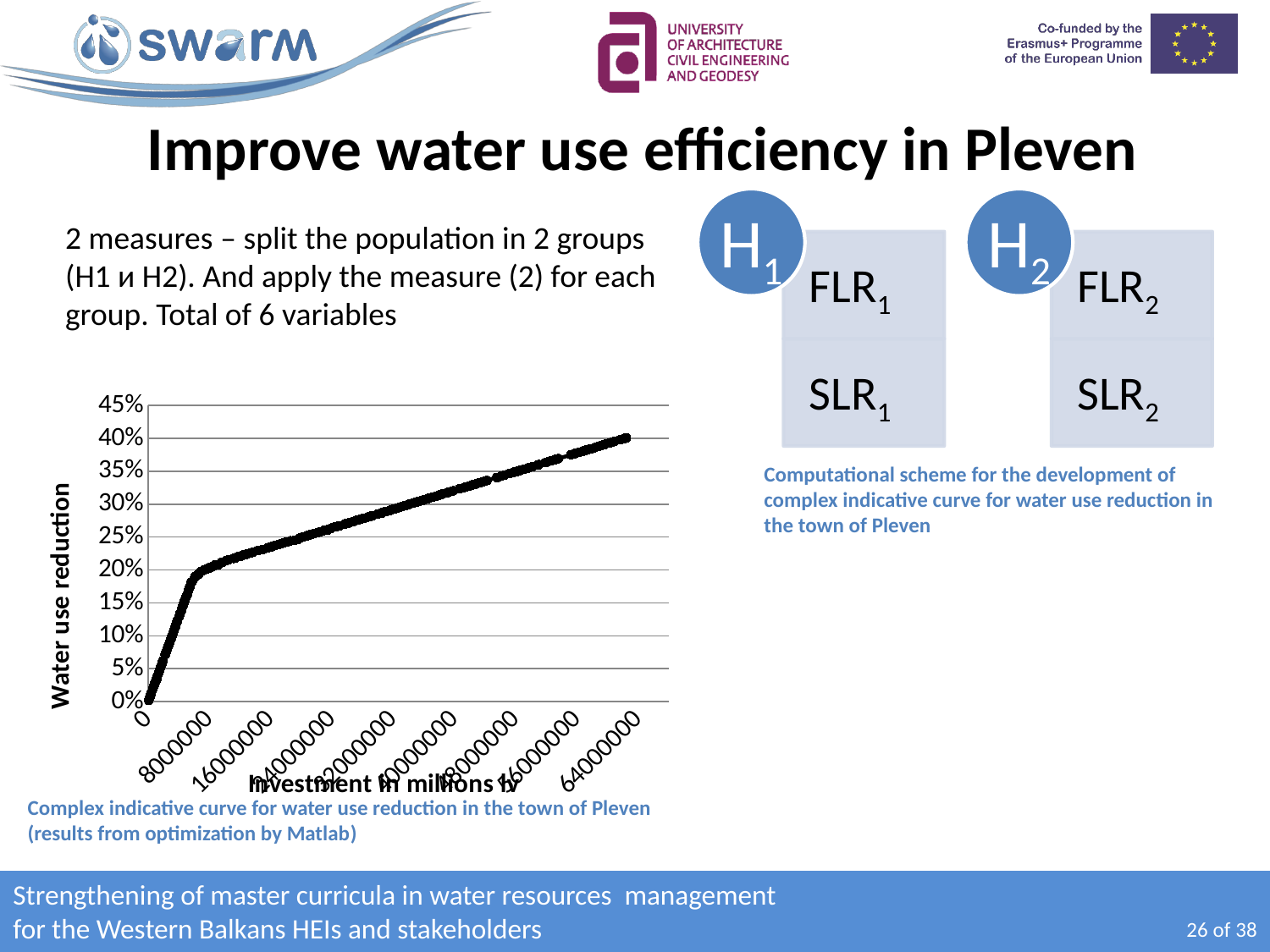
What kind of chart is shown on the slide? scatter chart What is the highest value shown on the vertical axis of the chart? 45% Does water use reduction rise or fall as investment increases along the x axis? rise Which investment level gives the larger water use reduction, 8000000 or 56000000? 56000000 Is the water use reduction at an investment of 8000000 greater or less than 15%? greater Is the water use reduction at an investment of 16000000 greater or less than 30%? less Is the water use reduction at an investment of 64000000 greater or less than 35%? greater What is the title of the vertical axis of the chart? Water use reduction